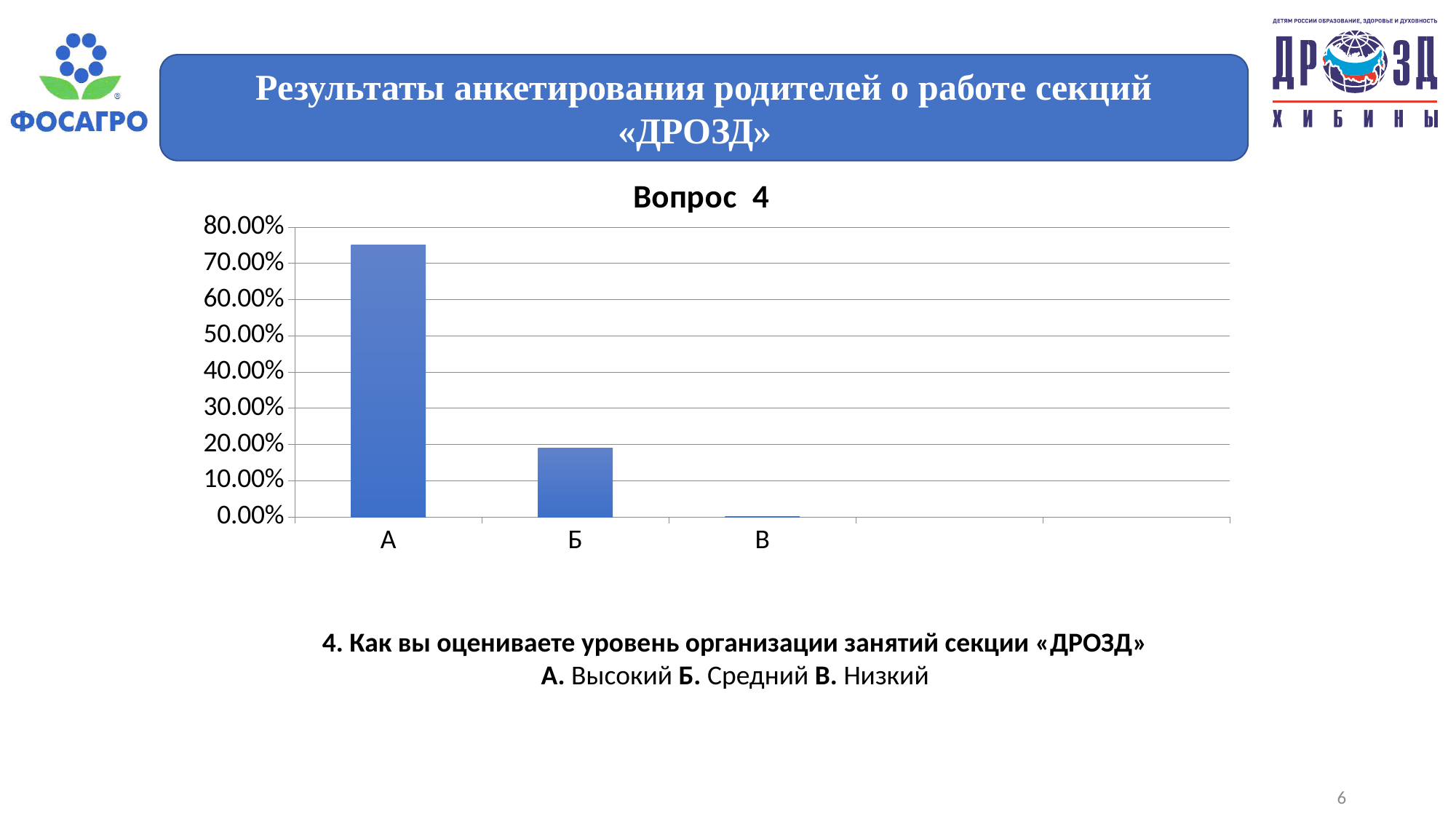
Is the value for А greater or less than 70.00%? greater Is the value for А greater or less than 80.00%? less Do the values rise or fall from А to В along the x axis? fall Which category has the highest value in the "Вопрос 4" chart? А How many categories are shown on the x axis of the "Вопрос 4" chart? 3 Which is larger in the "Вопрос 4" chart, the value for А or the value for Б? А What kind of chart is shown under the title "Вопрос 4"? bar chart Is the value for Б greater or less than 30.00%? less What is the title of the chart on the slide? Вопрос 4 Which category has the lowest value in the "Вопрос 4" chart? В